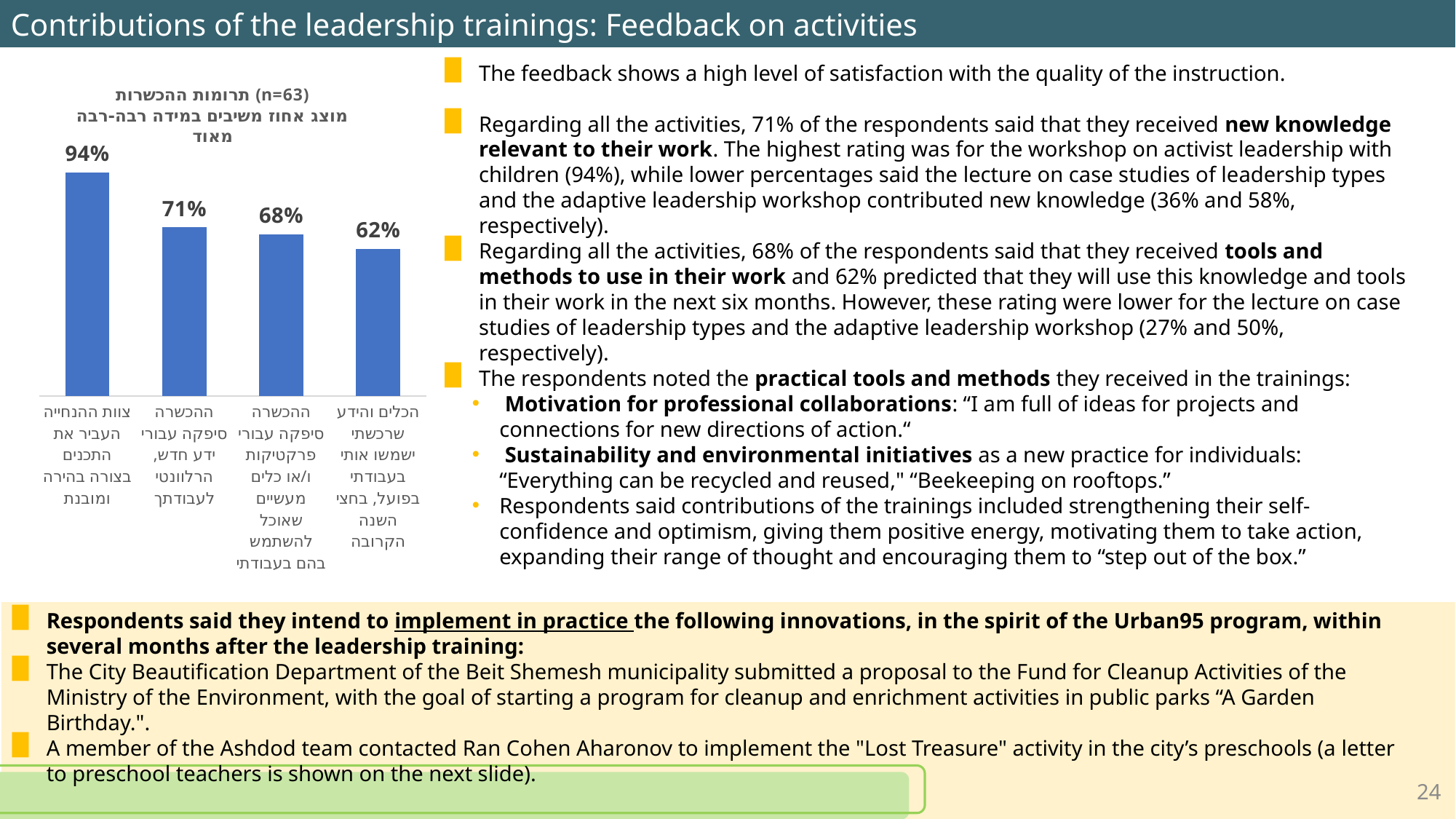
What is the value of the leftmost bar (צוות ההנחייה העביר את התכנים בצורה בהירה ומובנת)? 94% What type of chart is shown on the slide? bar chart What is the value of the rightmost bar (הכלים והידע שרכשתי ישמשו אותי בעבודתי בפועל)? 62% Which bar has the lowest value? הכלים והידע שרכשתי ישמשו אותי בעבודתי בפועל, בחצי השנה הקרובה (rightmost bar) Which is larger: the value for the second bar from the left or the third bar from the left? the second bar (71%) What is the difference between the highest bar (94%) and the lowest bar (62%)? 32% What is the value of the third bar from the left (ההכשרה סיפקה עבורי פרקטיקות ו/או כלים מעשיים)? 68% What sample size (n) is stated in the chart title? n=63 Which bar has the highest value? צוות ההנחייה העביר את התכנים בצורה בהירה ומובנת (leftmost bar) How many bars does the chart show? 4 What is the value of the bar labelled 'ההכשרה סיפקה עבורי ידע חדש, הרלוונטי לעבודתך'? 71% Do the bar values rise or fall from left to right? fall